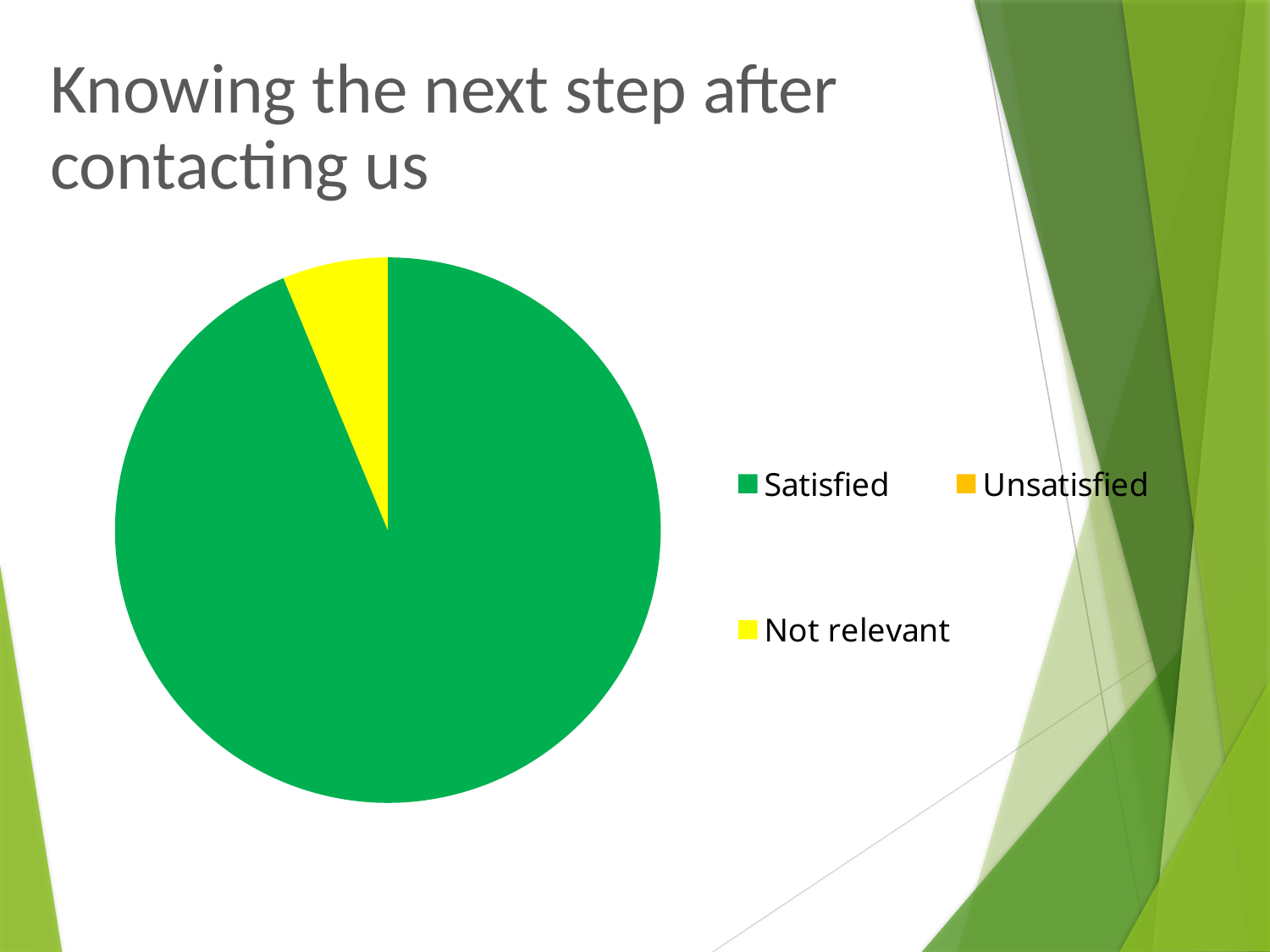
Which category has the largest slice of the pie chart? Satisfied What colour is the Satisfied slice in the pie chart? green Which slice is smaller, Satisfied or Not relevant? Not relevant What kind of chart is shown on the slide? pie chart Which slice is larger, Satisfied or Not relevant? Satisfied How many entries does the legend of the pie chart list? 3 What is the title of the slide containing the pie chart? Knowing the next step after contacting us Which legend entry is shown in yellow? Not relevant